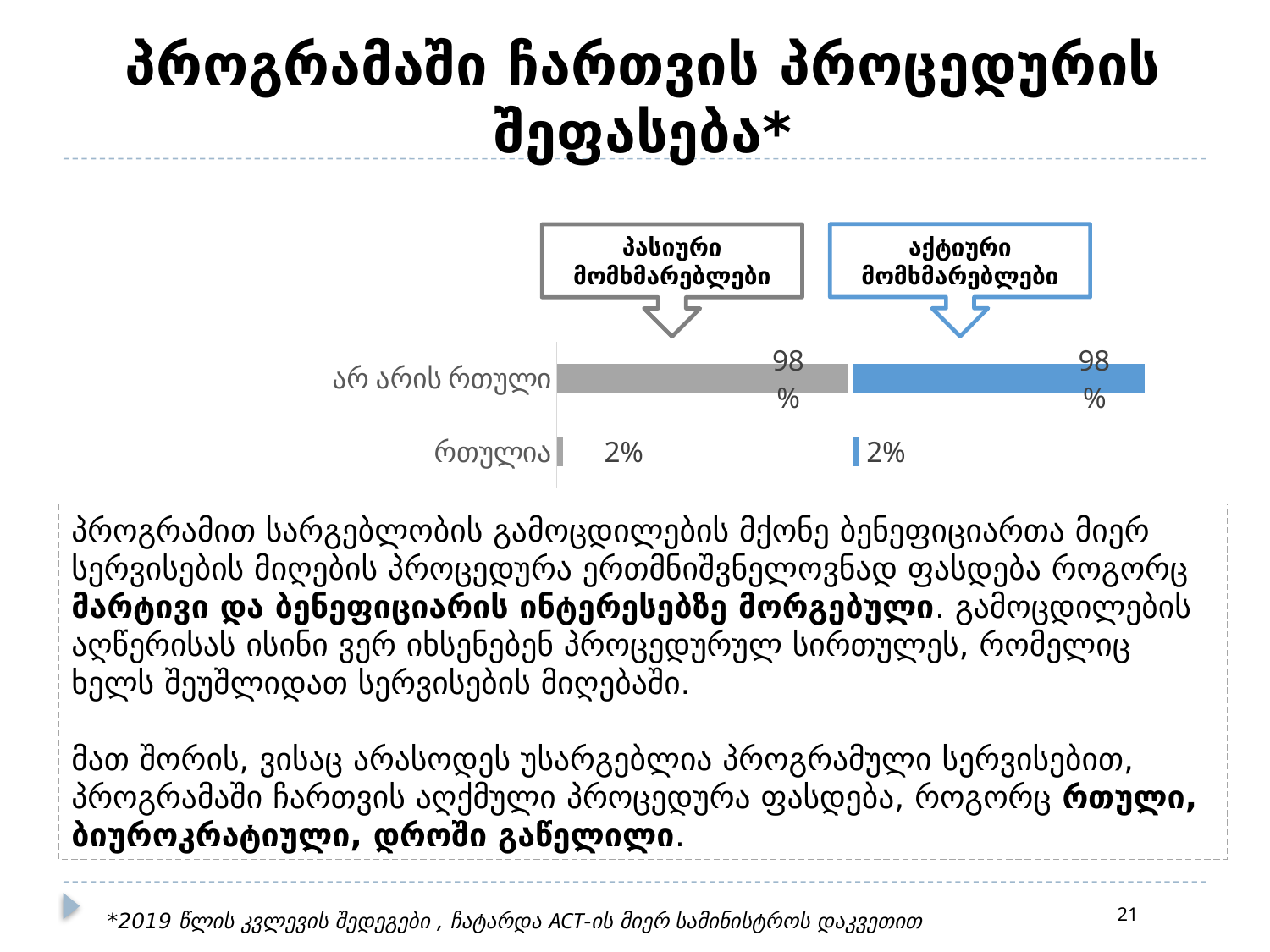
What value is shown for "არ არის რთული" in the "პასიური მომხმარებლები" (gray) series? 98% Which colour represents the "აქტიური მომხმარებლები" series? Blue Which category has the highest value in the "პასიური მომხმარებლები" series? არ არის რთული What value is shown for "არ არის რთული" in the "აქტიური მომხმარებლები" (blue) series? 98% What kind of chart is shown on the slide? Bar chart How many categories are shown on the chart? 2 What value is shown for "რთულია" in the "პასიური მომხმარებლები" (gray) series? 2% Which is larger for the "პასიური მომხმარებლები" series: "არ არის რთული" or "რთულია"? არ არის რთული What is the difference between the "არ არის რთული" and "რთულია" values for the "აქტიური მომხმარებლები" series? 96% What value is shown for "რთულია" in the "აქტიური მომხმარებლები" (blue) series? 2% How many series does the chart show? 2 Which category has the lowest value in the "აქტიური მომხმარებლები" series? რთულია